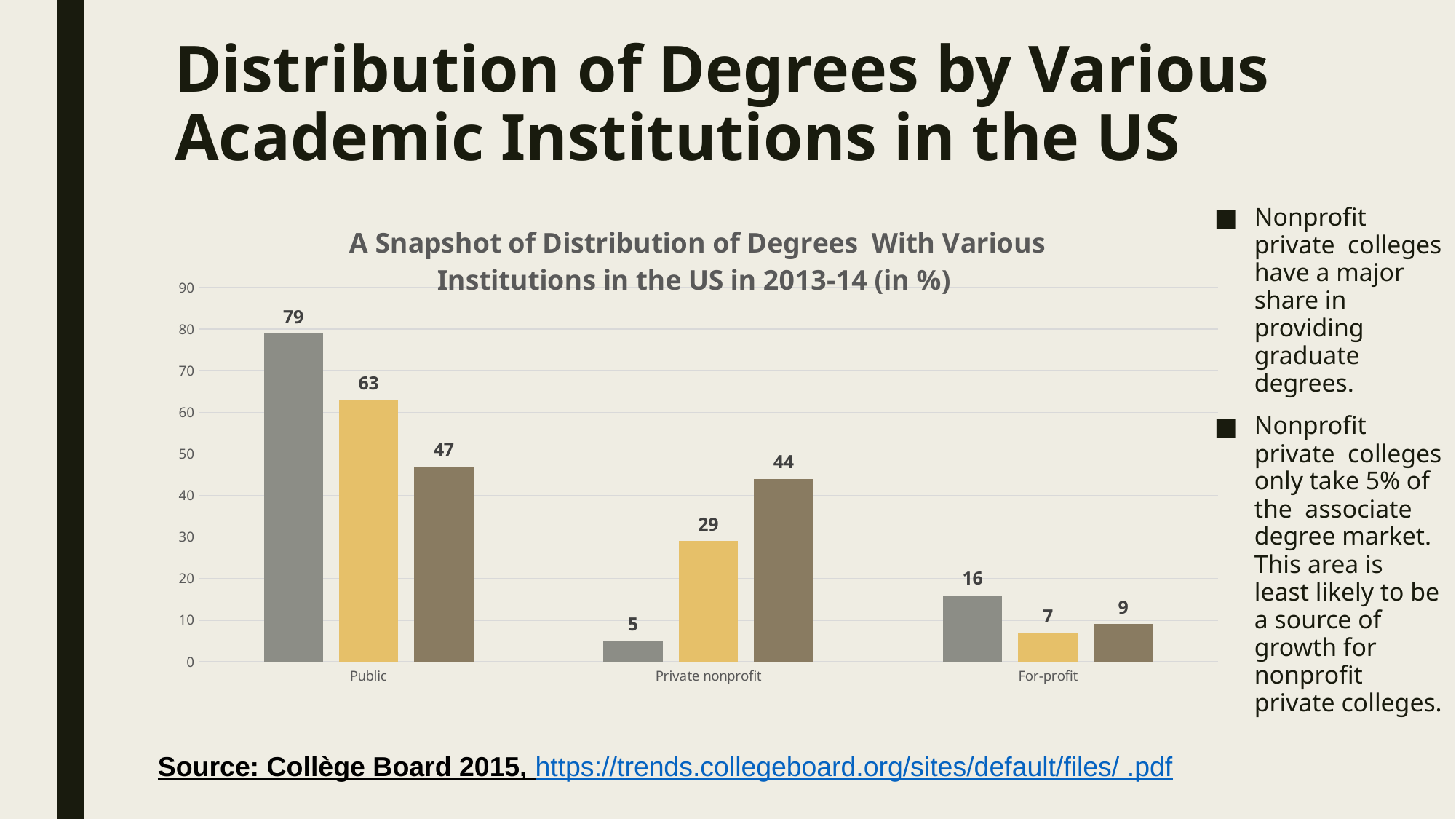
What is the value of the brown bar for For-profit? 9 What is the value of the gray bar for Public? 79 Which category has the lowest yellow bar? For-profit Which is larger: the brown bar for Private nonprofit or the brown bar for Public? Public What is the difference between the gray bar for Public (79) and the gray bar for For-profit (16)? 63 Which category has the highest gray bar? Public What type of chart is shown on the slide? bar chart How many categories are shown on the x axis of the chart? 3 Is the value of the yellow bar for Public greater or less than 60? greater What is the title of the chart? A Snapshot of Distribution of Degrees With Various Institutions in the US in 2013-14 (in %) Do the gray bars rise or fall from Public to Private nonprofit? fall What is the value of the yellow bar for Private nonprofit? 29